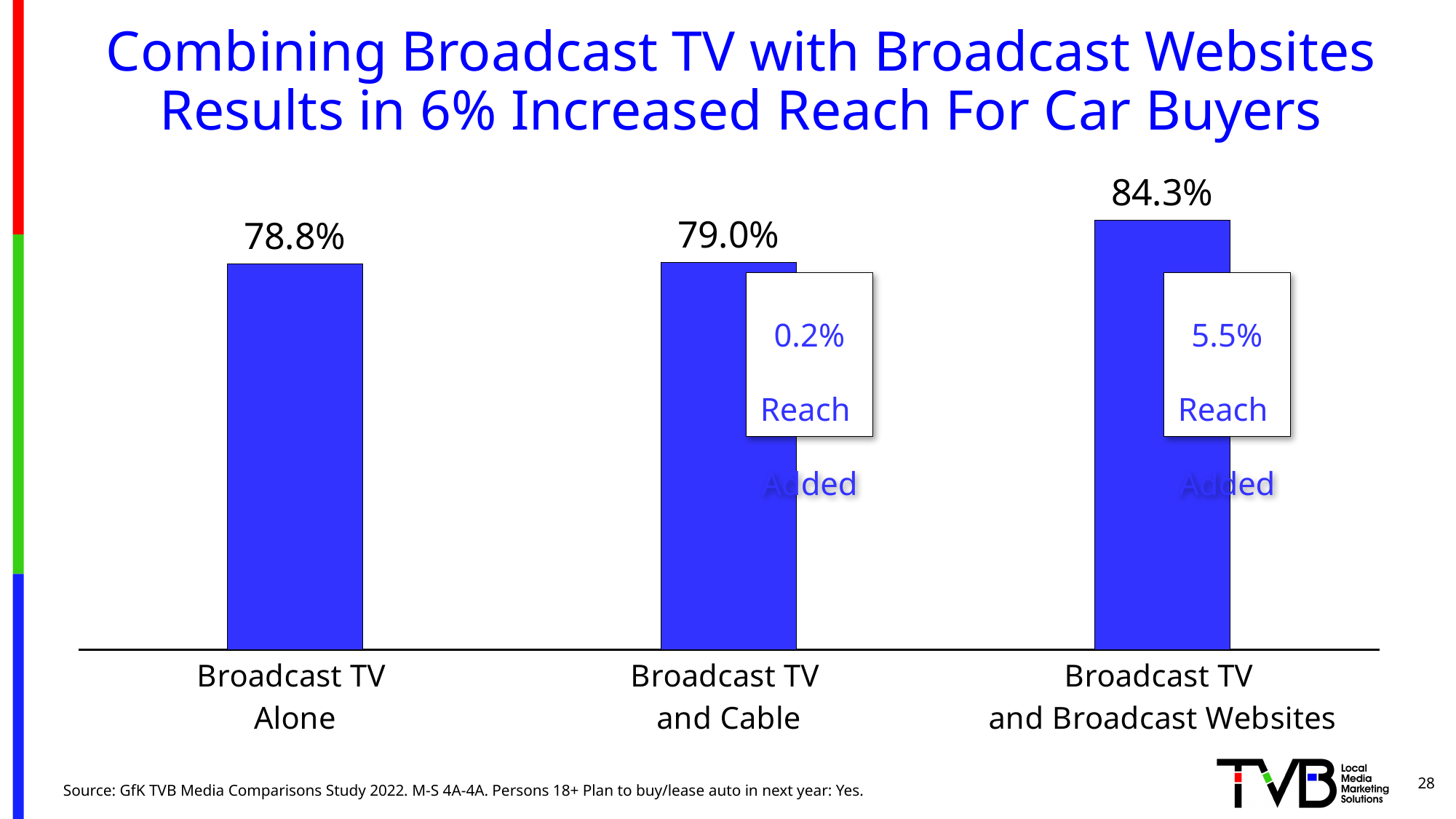
What is the difference between Broadcast TV and Cable and Broadcast TV Alone? 0.2% What kind of chart is shown on the slide? bar chart What is the value for Broadcast TV and Broadcast Websites? 84.3% How many categories are shown in the chart? 3 Which category has the highest value? Broadcast TV and Broadcast Websites What is the value for Broadcast TV Alone? 78.8% What reach added is shown in the callout box for Broadcast TV and Broadcast Websites? 5.5% Reach Added Which is larger: Broadcast TV and Broadcast Websites or Broadcast TV and Cable? Broadcast TV and Broadcast Websites What is the difference between Broadcast TV and Broadcast Websites and Broadcast TV Alone? 5.5% What is the value for Broadcast TV and Cable? 79.0% Which category has the lowest value? Broadcast TV Alone Do the values rise or fall from left to right across the categories? rise